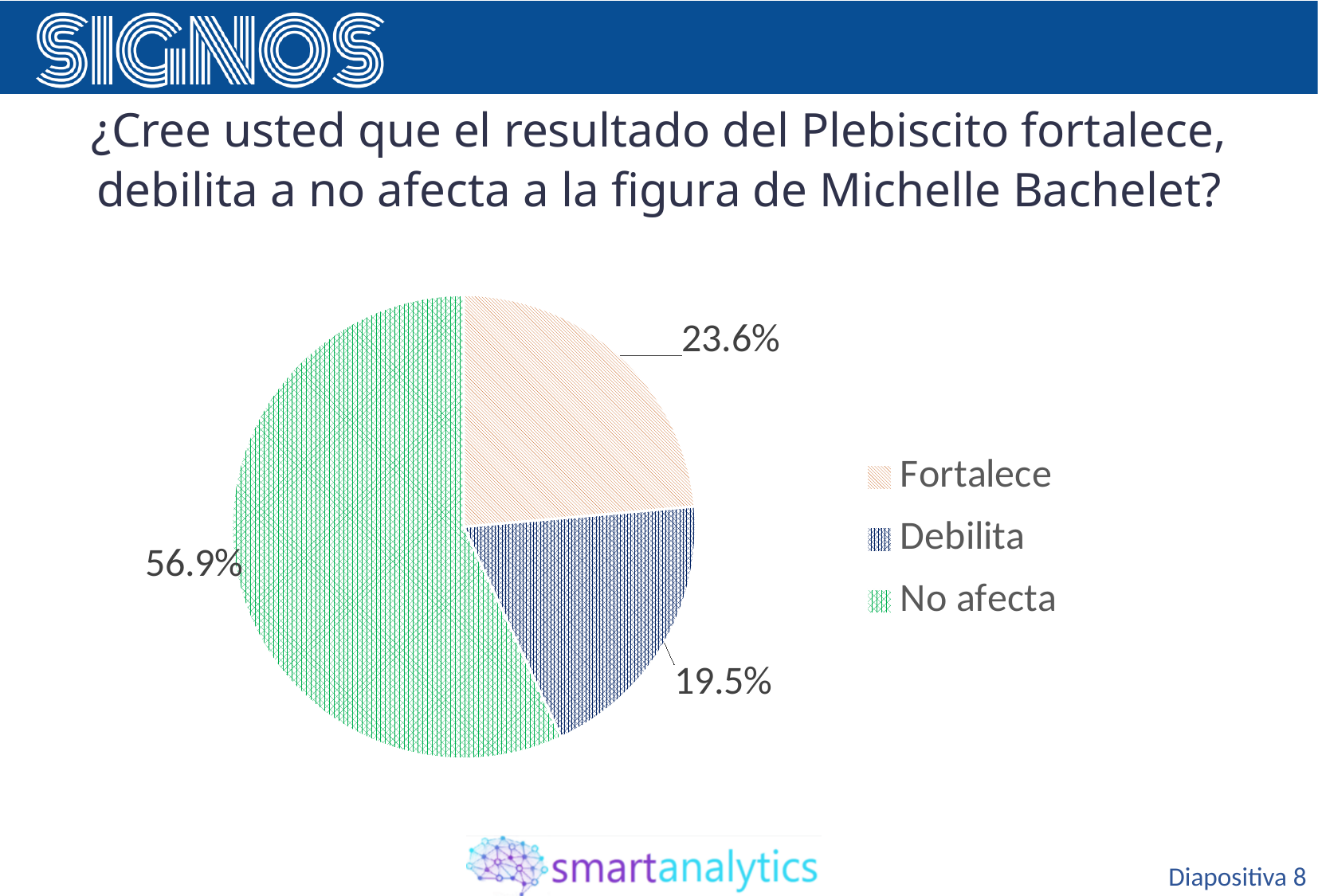
How many entries does the legend list? 3 Which response has the largest share of the pie? No afecta Which is larger, the share for "Fortalece" or the share for "Debilita"? Fortalece What is the difference in percentage points between "No afecta" and "Fortalece"? 33.3 Which response has the smallest share of the pie? Debilita What percentage of respondents answered "Fortalece"? 23.6% What is the difference in percentage points between "Fortalece" and "Debilita"? 4.1 What percentage of respondents answered "No afecta"? 56.9% How many categories does the pie chart show? 3 What kind of chart is shown on the slide? Pie chart What percentage of respondents answered "Debilita"? 19.5% Which legend entry is shown with a green pattern? No afecta